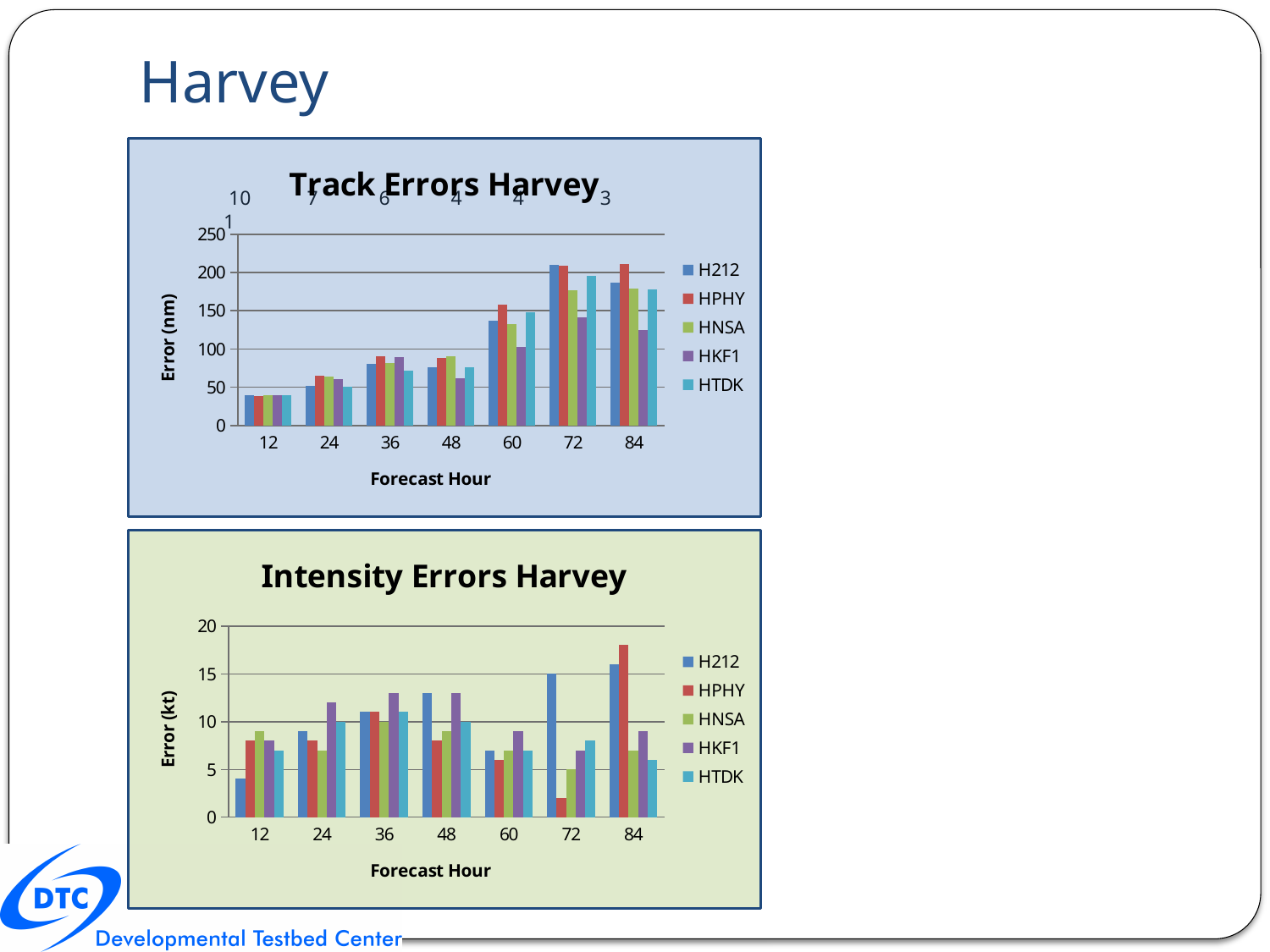
In the Intensity Errors Harvey chart, which series has the highest error at forecast hour 84? HPHY In the Intensity Errors Harvey chart, at forecast hour 72, which is larger: H212 or HNSA? H212 In the Track Errors Harvey chart, how many series does the legend list? 5 In the Track Errors Harvey chart, how many forecast hours are shown on the x axis? 7 What kind of chart is the Intensity Errors Harvey chart? bar chart In the Intensity Errors Harvey chart, is the value for H212 at forecast hour 72 greater or less than 10? greater In the Track Errors Harvey chart, is the value for HKF1 at forecast hour 84 greater or less than 100? greater In the Track Errors Harvey chart, do the errors generally rise or fall from forecast hour 12 to forecast hour 72? rise In the Intensity Errors Harvey chart, which series has the lowest error at forecast hour 72? HPHY In the Track Errors Harvey chart, is the value for H212 at forecast hour 84 greater or less than 200? less In the Track Errors Harvey chart, which series has the highest error at forecast hour 60? HPHY In the Track Errors Harvey chart, which series has the lowest error at forecast hour 72? HKF1